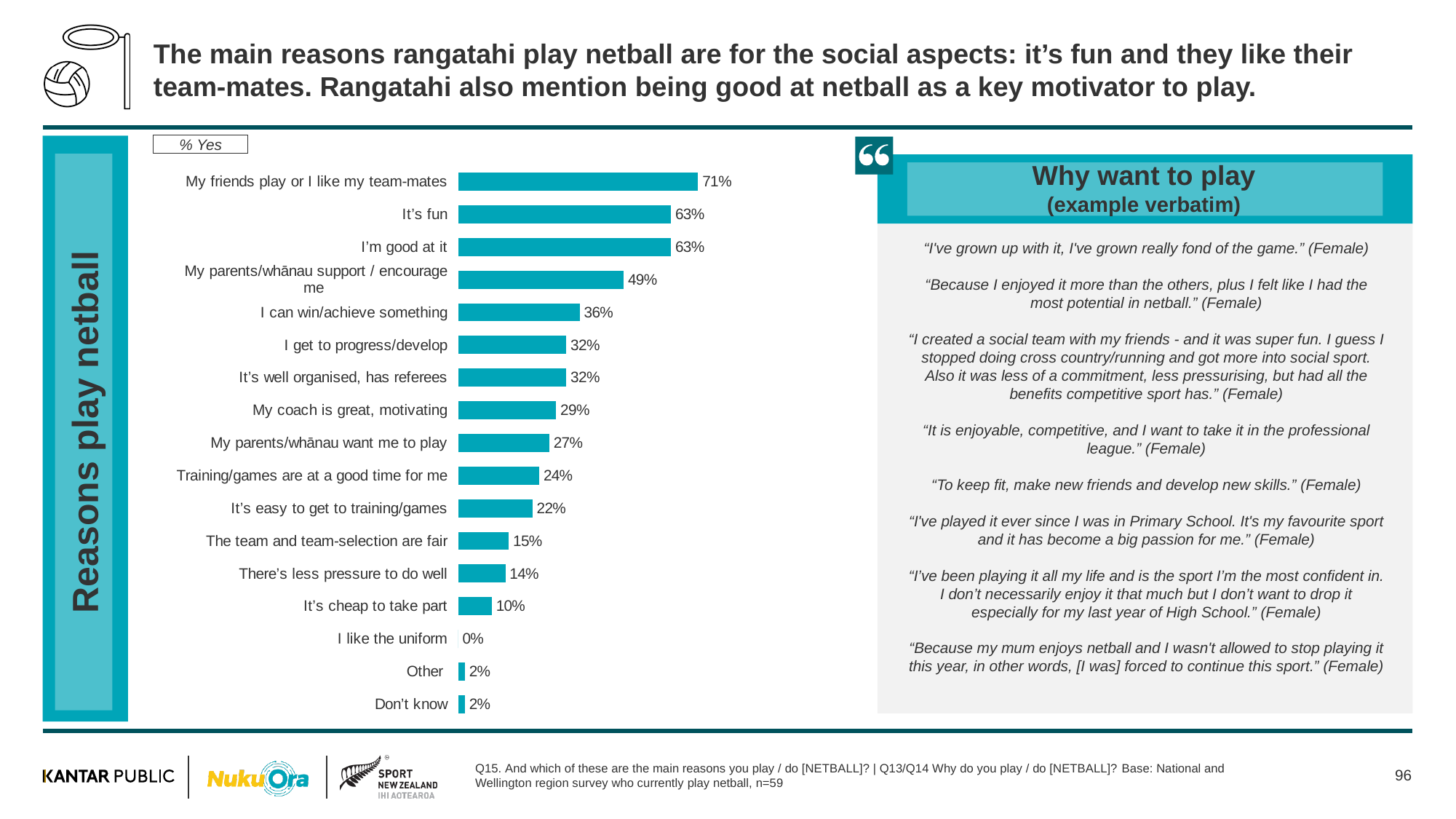
What percentage of rangatahi say they play netball because their friends play or they like their team-mates? 71% What type of chart is used to show the reasons rangatahi play netball? Bar chart What label appears in the box above the bar chart indicating what the values represent? % Yes What is the difference between "My friends play or I like my team-mates" and "It's fun"? 8 percentage points What is the difference between "My parents/whānau support / encourage me" and "My parents/whānau want me to play"? 22 percentage points What is the value for "I can win/achieve something"? 36% Which reason for playing netball has the highest percentage? My friends play or I like my team-mates Which is larger: the value for "My coach is great, motivating" or the value for "Training/games are at a good time for me"? My coach is great, motivating Which reason for playing netball has the lowest percentage? I like the uniform How many reasons (categories) are shown in the bar chart? 17 What percentage say "It's cheap to take part" is a reason they play netball? 10% Which two reasons both have a value of 63%? It's fun; I'm good at it